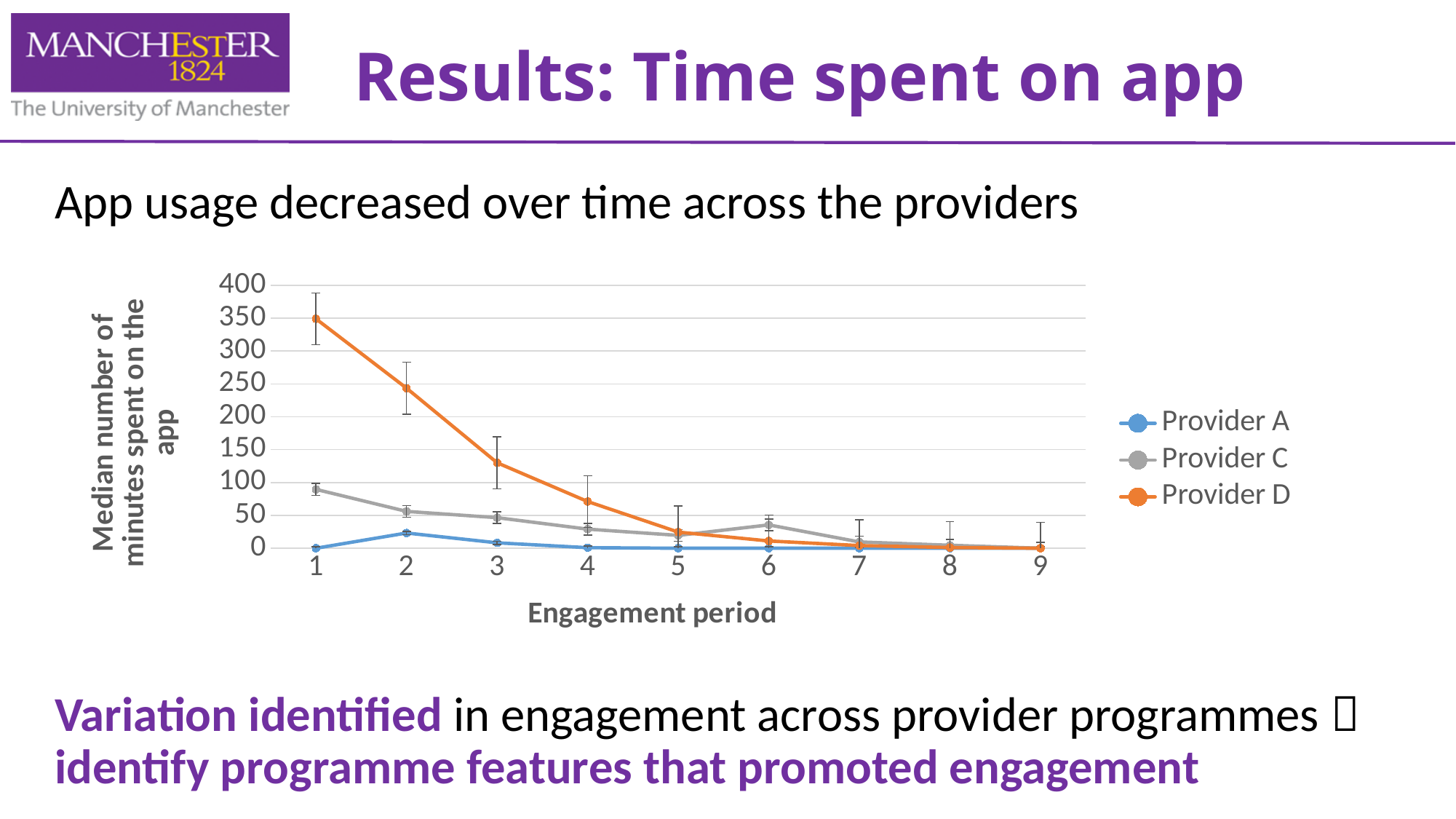
What kind of chart is shown on the slide? line chart Is the value for Provider D at engagement period 4 greater or less than 100? less Is the value for Provider D at engagement period 1 greater or less than 300? greater Do the values for Provider D rise or fall across the engagement periods? fall How many series does the legend list? 3 Which provider has the highest median number of minutes spent on the app at engagement period 1? Provider D How many engagement periods are shown on the x axis? 9 Is the value for Provider C at engagement period 1 greater or less than 100? less At engagement period 3, which is larger: the value for Provider D or the value for Provider C? Provider D What is the title of the x axis? Engagement period Which provider has the lowest median number of minutes spent on the app at engagement period 1? Provider A